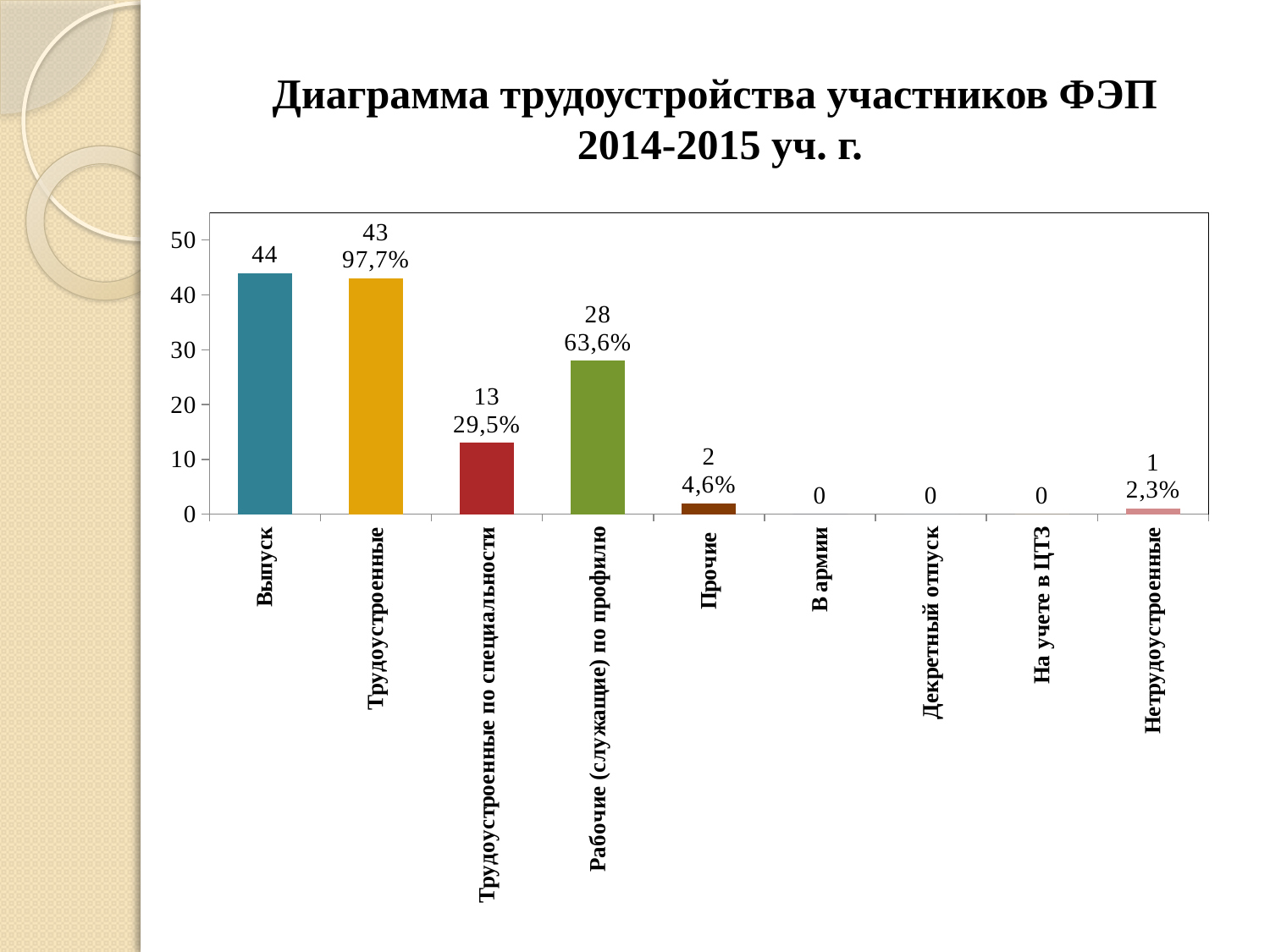
Which category has the highest value? Выпуск What is the difference between the values for Рабочие (служащие) по профилю and Трудоустроенные по специальности? 15 What is the value for Рабочие (служащие) по профилю? 28 Which is larger, the value for Прочие or the value for Нетрудоустроенные? Прочие What percentage is shown for Нетрудоустроенные? 2,3% What is the difference between the values for Выпуск and Трудоустроенные? 1 What type of chart is shown on the slide? Bar chart How many categories have a value of 0? 3 How many categories are shown on the x axis? 9 What percentage is shown for Трудоустроенные по специальности? 29,5% What is the value for Трудоустроенные? 43 What is the value for Выпуск? 44